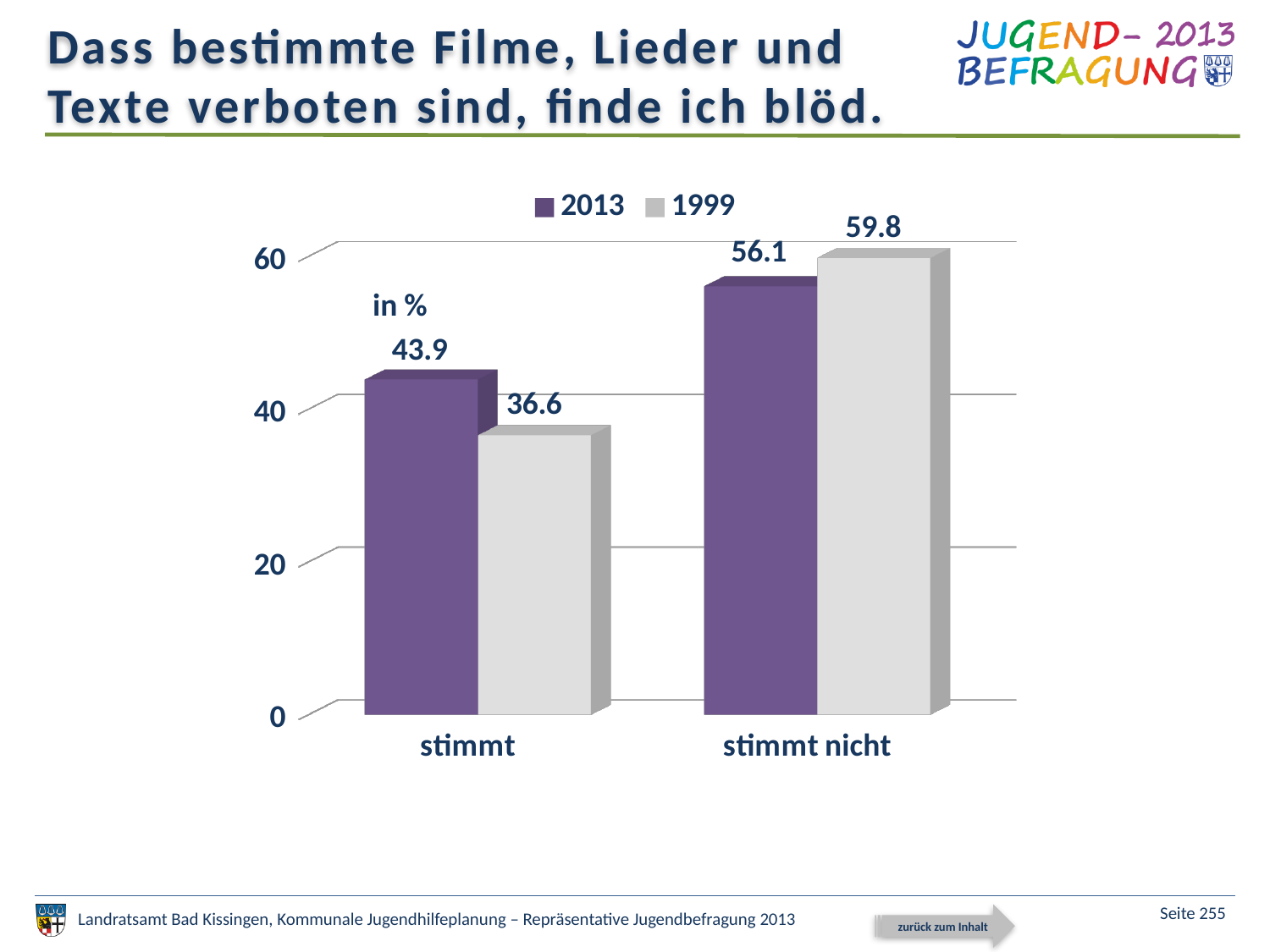
What is the value for 1999 in the "stimmt" category? 36.6 Which category has the lowest value for the 1999 series? stimmt What is the value for 1999 in the "stimmt nicht" category? 59.8 What is the value for 2013 in the "stimmt" category? 43.9 What is the value for 2013 in the "stimmt nicht" category? 56.1 How many categories are shown on the x axis? 2 How many series does the legend list? 2 What is the difference between the 1999 and 2013 values in the "stimmt nicht" category? 3.7 Which category has the highest value for the 2013 series? stimmt nicht In the "stimmt nicht" category, which series has the larger value, 2013 or 1999? 1999 What kind of chart is shown on the slide? bar chart What is the difference between the 2013 and 1999 values in the "stimmt" category? 7.3